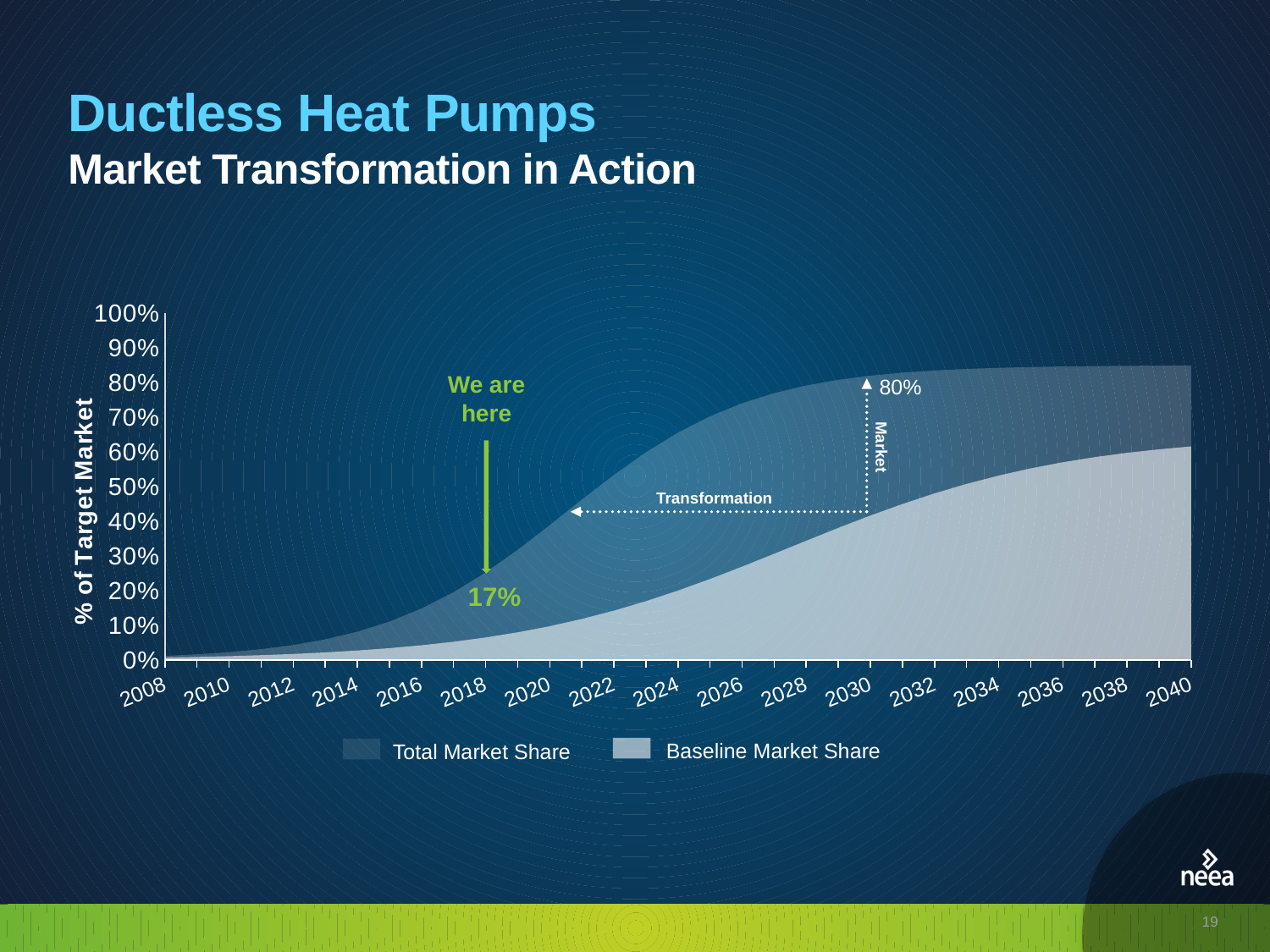
What are the two series named in the chart legend? Total Market Share and Baseline Market Share Do the Total Market Share values rise or fall from 2008 to 2040? Rise What value is labelled for Total Market Share at 2030 on the chart? 80% Is the Baseline Market Share value at 2020 greater or less than 20%? less At 2030, which series is larger: Total Market Share or Baseline Market Share? Total Market Share Is the Baseline Market Share value at 2040 greater or less than 50%? greater How much higher is the 80% value labelled at 2030 than the 17% value labelled at 2018? 63% What value is labelled at the 'We are here' marker on the chart? 17% In which year is the 'We are here' marker placed on the chart? 2018 What is the label on the chart's vertical axis? % of Target Market How many series does the chart legend list? 2 What kind of chart is shown on the slide? Area chart